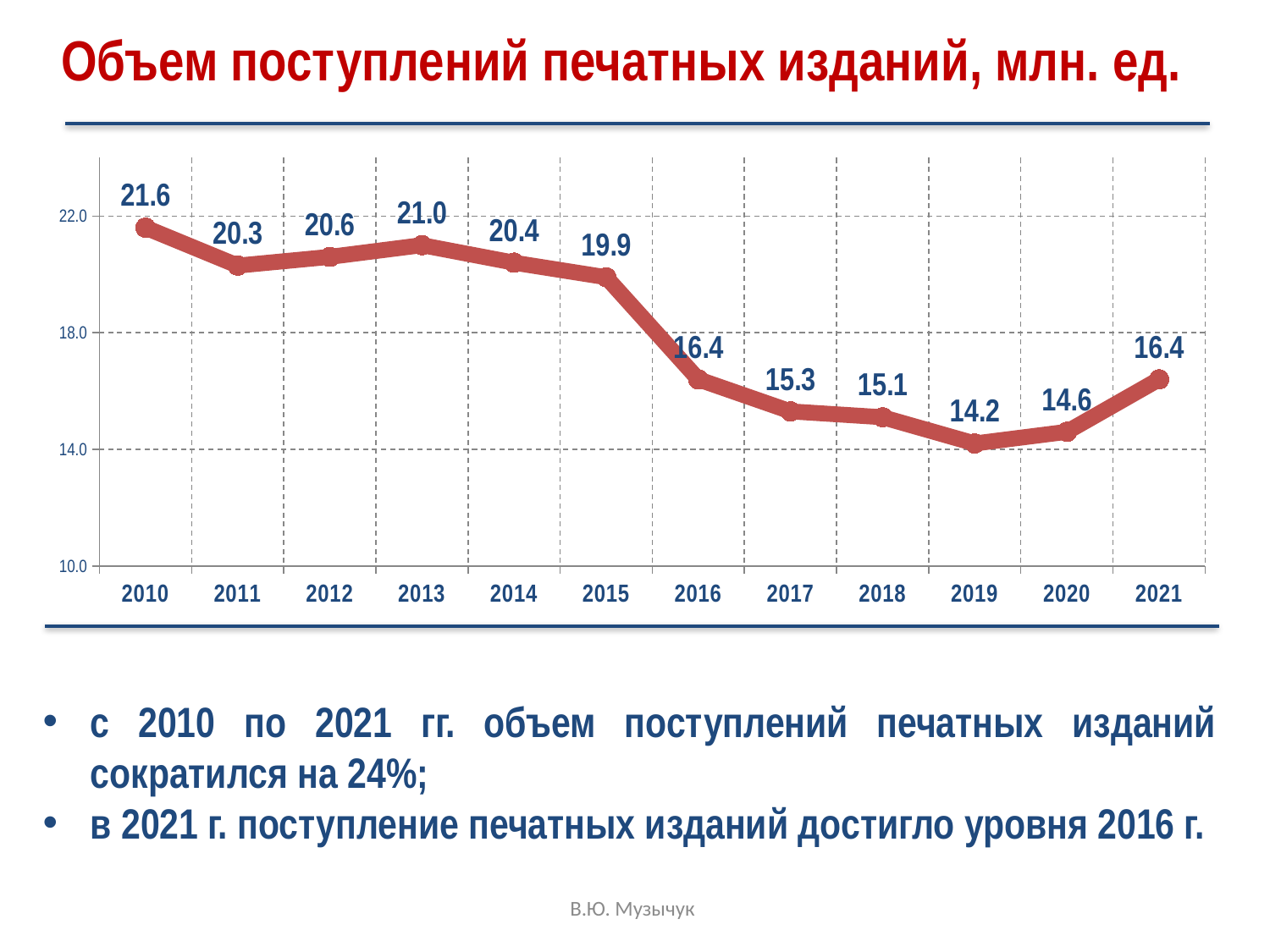
What is the difference between the values for 2015 and 2016? 3.5 Which is larger, the value for 2013 or the value for 2014? 2013 Which year has the lowest value? 2019 How many years are plotted on the chart? 12 Which year has the highest value? 2010 Is the value for 2017 greater or less than 18.0? less What is the difference between the values for 2010 and 2021? 5.2 What kind of chart is shown on the slide? line chart What is the value for 2015? 19.9 What is the value for 2019? 14.2 Do the values generally rise or fall from 2010 to 2019? fall What is the value for 2010? 21.6